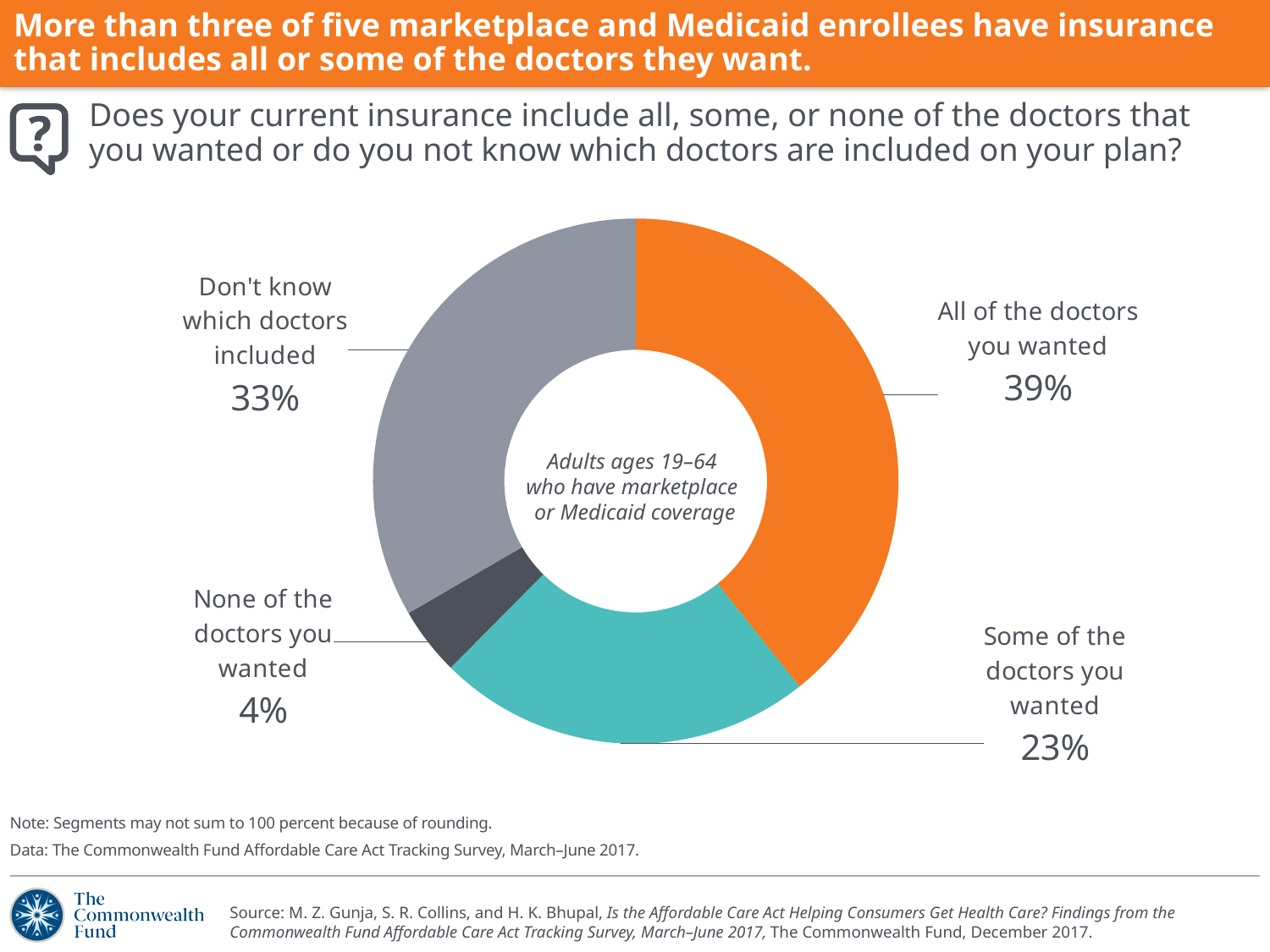
How many response categories are shown in the chart? 4 What percentage of adults said their insurance includes none of the doctors they wanted? 4% What is the combined share of adults whose insurance includes all or some of the doctors they wanted? 62% Which response category has the largest share of the chart? All of the doctors you wanted What population does the text in the center of the chart describe? Adults ages 19–64 who have marketplace or Medicaid coverage Which response category has the smallest share of the chart? None of the doctors you wanted Which is larger: the share for 'Don't know which doctors included' or the share for 'Some of the doctors you wanted'? Don't know which doctors included What percentage of adults said they don't know which doctors are included? 33% What type of chart is shown on the slide? Pie chart (donut) What percentage of adults said their insurance includes some of the doctors they wanted? 23% What percentage of adults said their insurance includes all of the doctors they wanted? 39% What is the difference in percentage points between 'All of the doctors you wanted' and 'Some of the doctors you wanted'? 16 percentage points